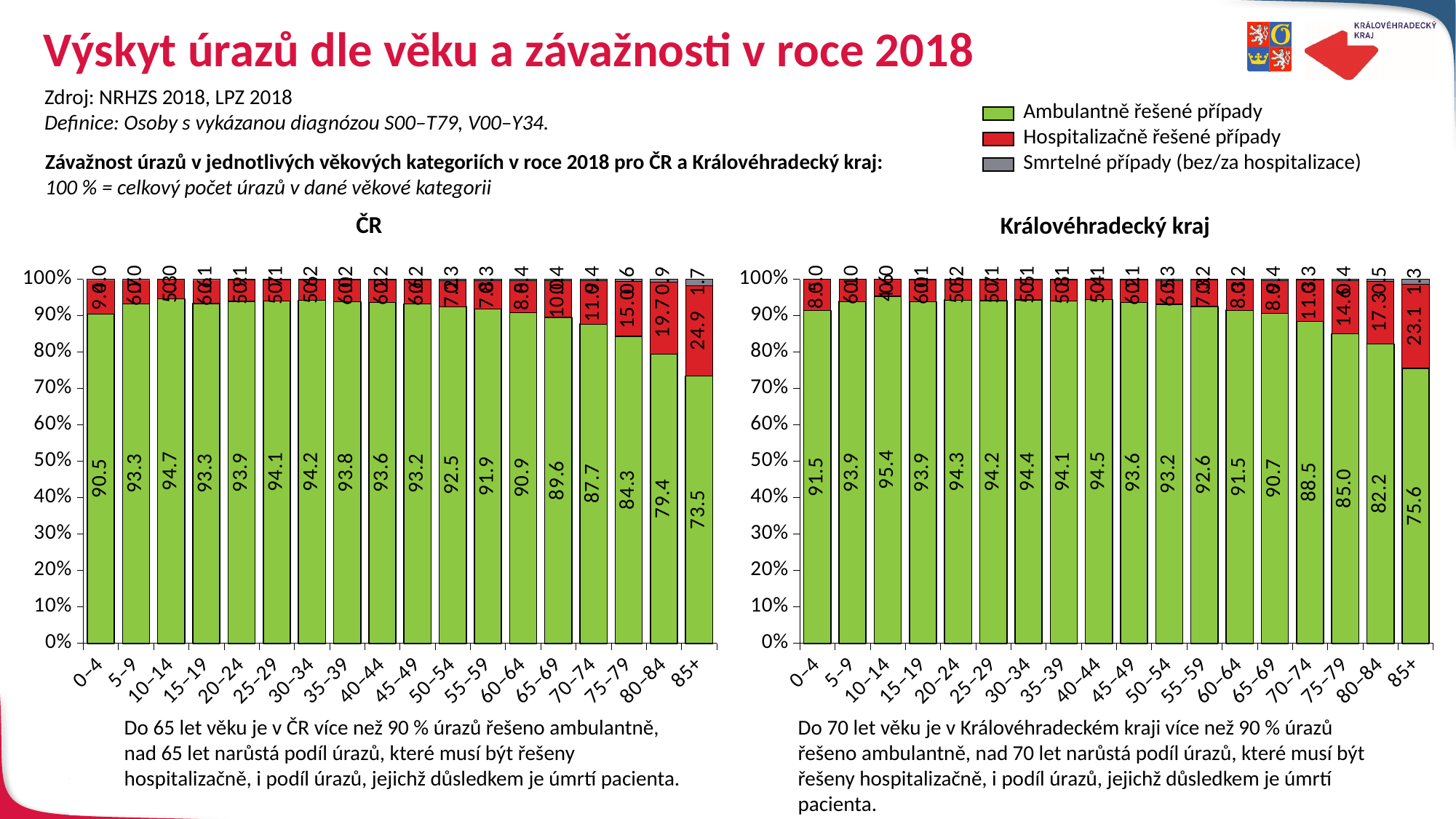
In the Královéhradecký kraj chart, which is larger: the Ambulantně řešené případy value for 75–79 or for 80–84? 75–79 In the Královéhradecký kraj chart, what is the value of Hospitalizačně řešené případy for the 80–84 age group? 17.3 In the Královéhradecký kraj chart, what is the value of Ambulantně řešené případy for the 85+ age group? 75.6 How many age groups are shown on the x axis of the Královéhradecký kraj chart? 18 In the ČR chart, what is the value of Hospitalizačně řešené případy for the 85+ age group? 24.9 In the Královéhradecký kraj chart, which age group has the lowest share of Ambulantně řešené případy? 85+ How many series does the legend list for the charts? 3 What kind of chart is the ČR chart? Stacked bar chart In the ČR chart, is the Ambulantně řešené případy value for the 80–84 age group greater or less than 80%? less In the ČR chart, which age group has the highest share of Ambulantně řešené případy? 10–14 In the ČR chart, what is the difference between the Ambulantně řešené případy values for the 10–14 and 85+ age groups? 21.2 In the ČR chart, what is the value of Ambulantně řešené případy for the 0–4 age group? 90.5